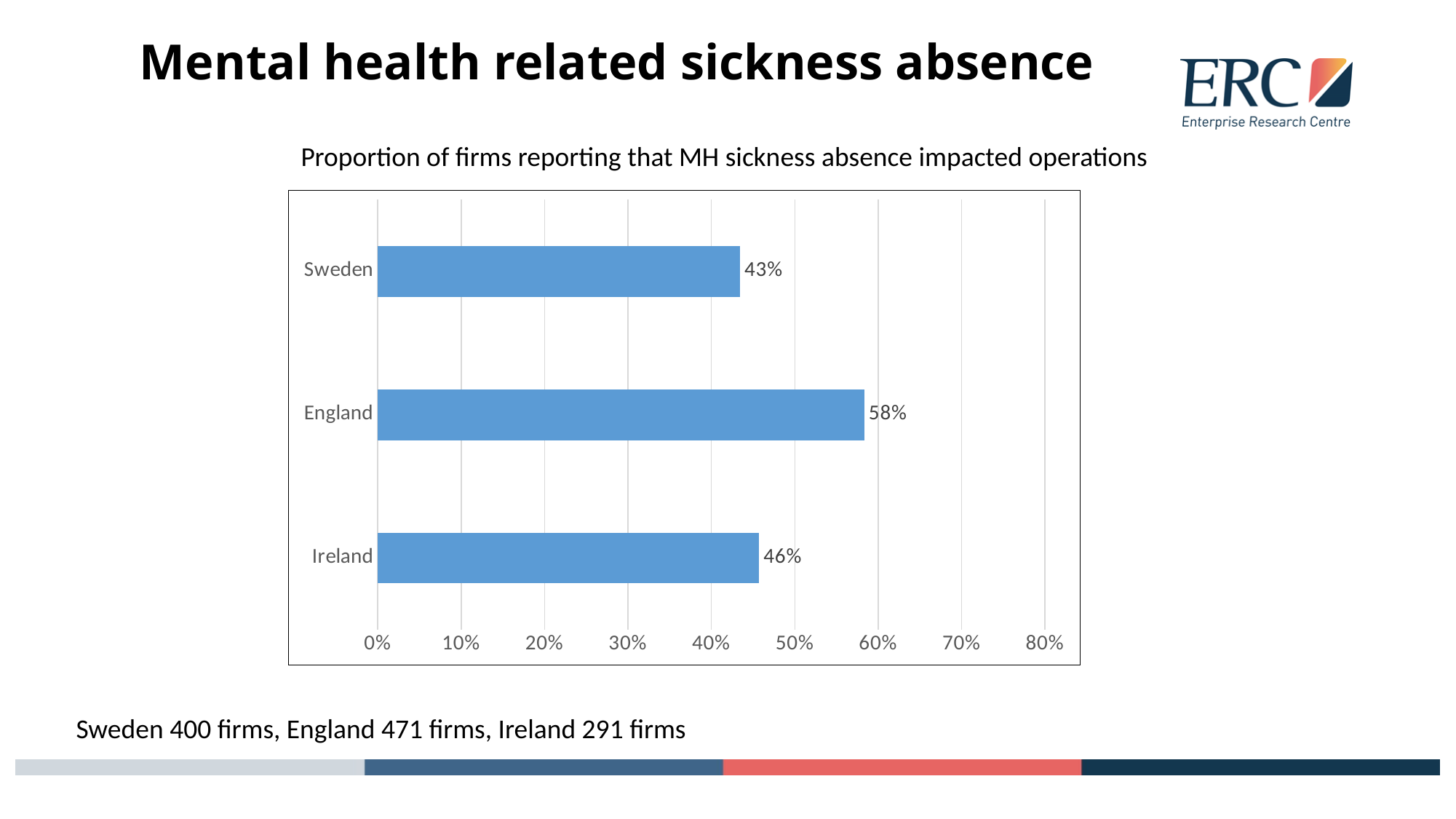
Which has a higher value, Ireland or Sweden? Ireland What kind of chart is shown on the slide? Bar chart Which country has the highest proportion of firms reporting that MH sickness absence impacted operations? England What is the title of the chart? Proportion of firms reporting that MH sickness absence impacted operations What proportion of firms in Ireland reported that MH sickness absence impacted operations? 46% What is the difference in percentage points between Ireland and Sweden? 3 percentage points What proportion of firms in Sweden reported that MH sickness absence impacted operations? 43% Which country has the lowest proportion of firms reporting that MH sickness absence impacted operations? Sweden Is the value for England greater or less than 50%? greater What proportion of firms in England reported that MH sickness absence impacted operations? 58% How many countries are shown in the chart? 3 What is the difference in percentage points between England and Sweden? 15 percentage points